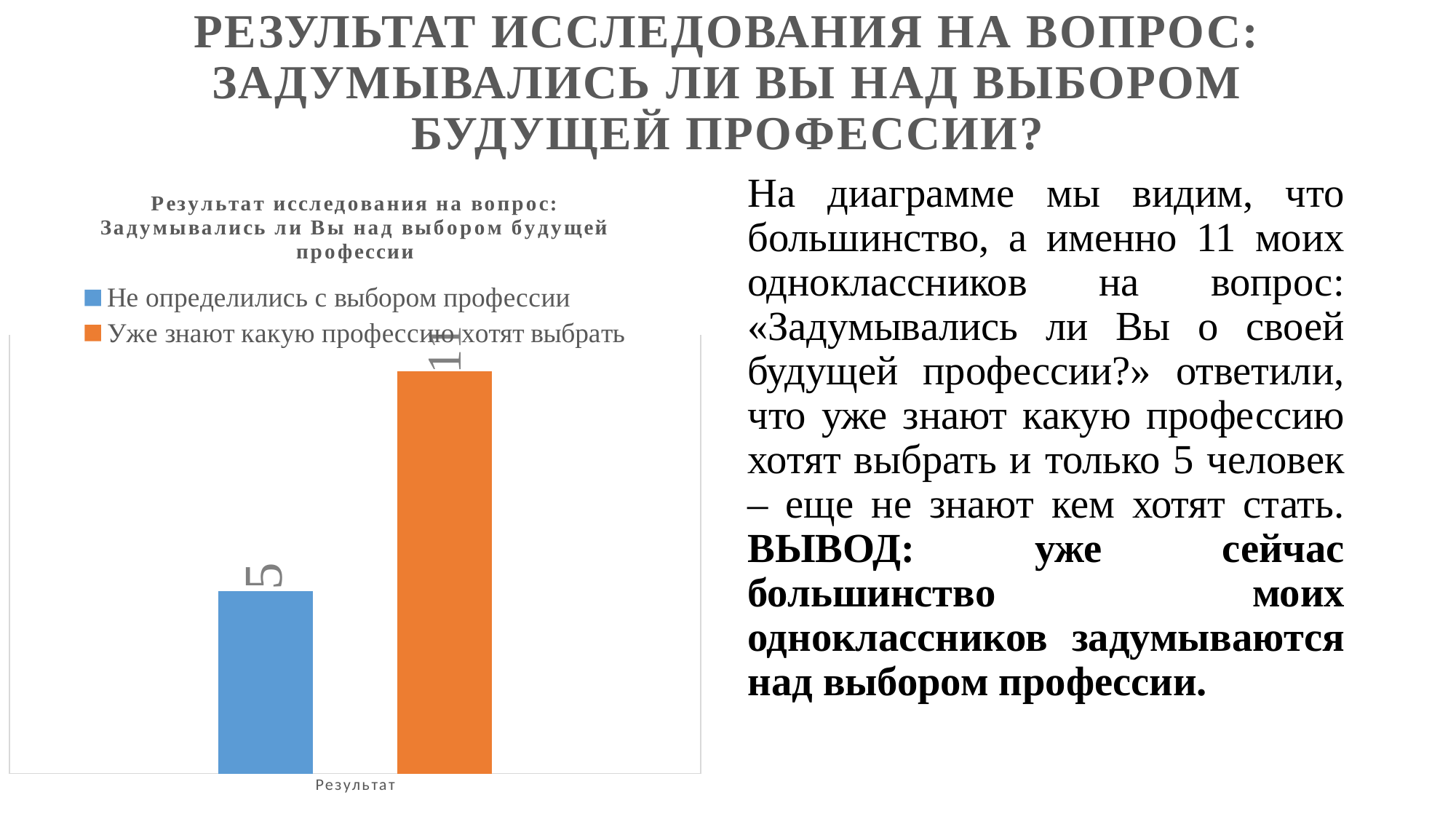
What is the value of the bar for "Не определились с выбором профессии"? 5 How many series does the chart legend list? 2 What is the label of the category on the x axis of the chart? Результат What is the difference between the values for "Уже знают какую профессию хотят выбрать" and "Не определились с выбором профессии"? 6 What is the value of the bar for "Уже знают какую профессию хотят выбрать"? 11 Which series has the higher bar in the chart? Уже знают какую профессию хотят выбрать How many categories are shown on the x axis of the chart? 1 Which series has the lower bar in the chart? Не определились с выбором профессии Is the bar for "Уже знают какую профессию хотят выбрать" larger or smaller than the bar for "Не определились с выбором профессии"? Larger What kind of chart is shown on the slide? Bar chart Which colour represents "Не определились с выбором профессии" in the chart? Blue